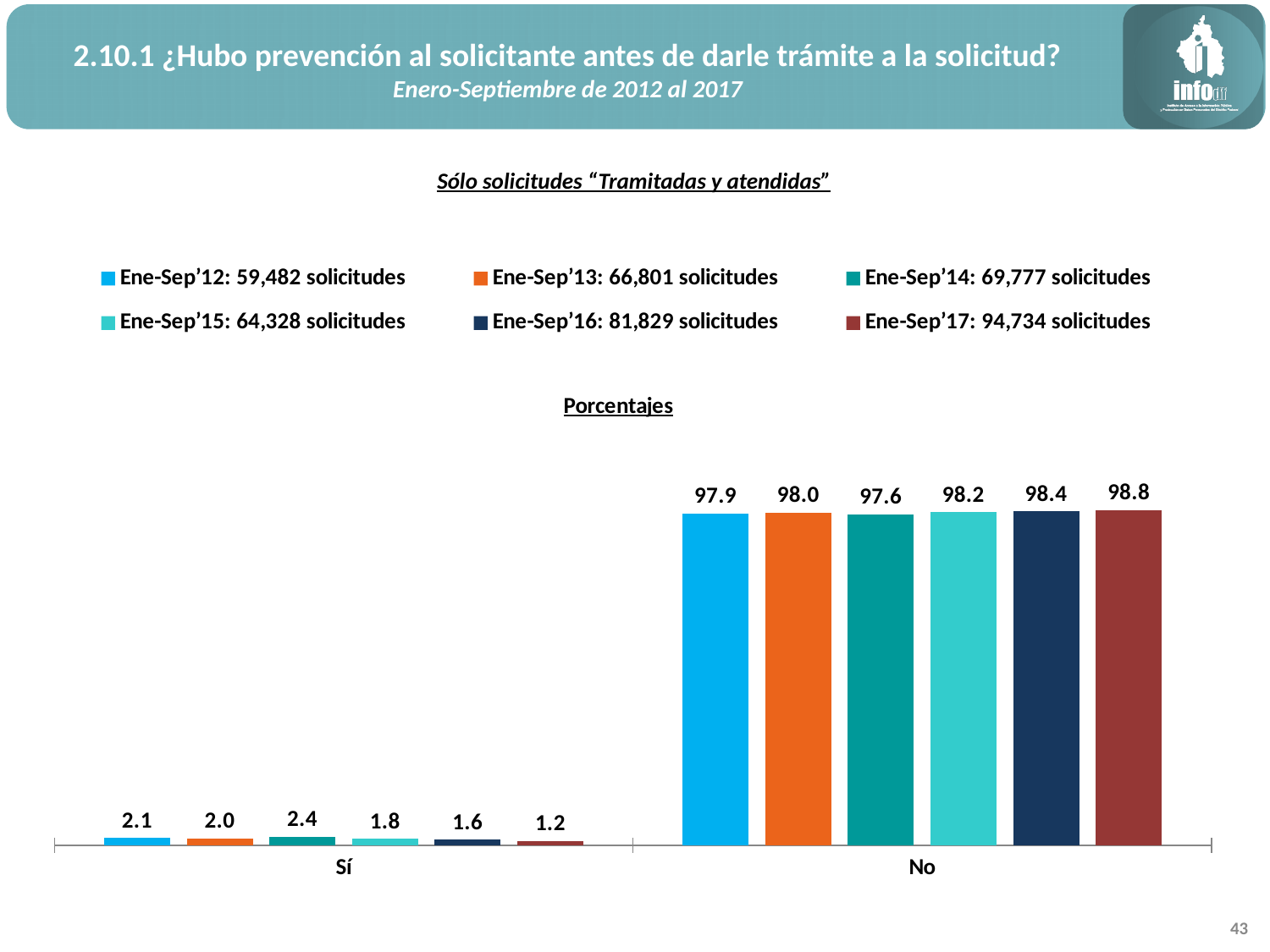
What is the value for Ene-Sep'14 in the "Sí" category? 2.4 Which series has the lowest value in the "No" category? Ene-Sep'14 How many series does the legend list? 6 What is the difference between the Ene-Sep'17 and Ene-Sep'12 values in the "No" category? 0.9 What kind of chart is shown on the slide? Bar chart How many solicitudes does the legend give for Ene-Sep'16? 81,829 solicitudes What is the value for Ene-Sep'17 in the "No" category? 98.8 What is the value for Ene-Sep'12 in the "Sí" category? 2.1 Which is larger in the "Sí" category: Ene-Sep'15 or Ene-Sep'16? Ene-Sep'15 Which series has the highest value in the "Sí" category? Ene-Sep'14 How many categories are shown on the x axis? 2 Do the values in the "Sí" category rise or fall from Ene-Sep'14 to Ene-Sep'17? Fall